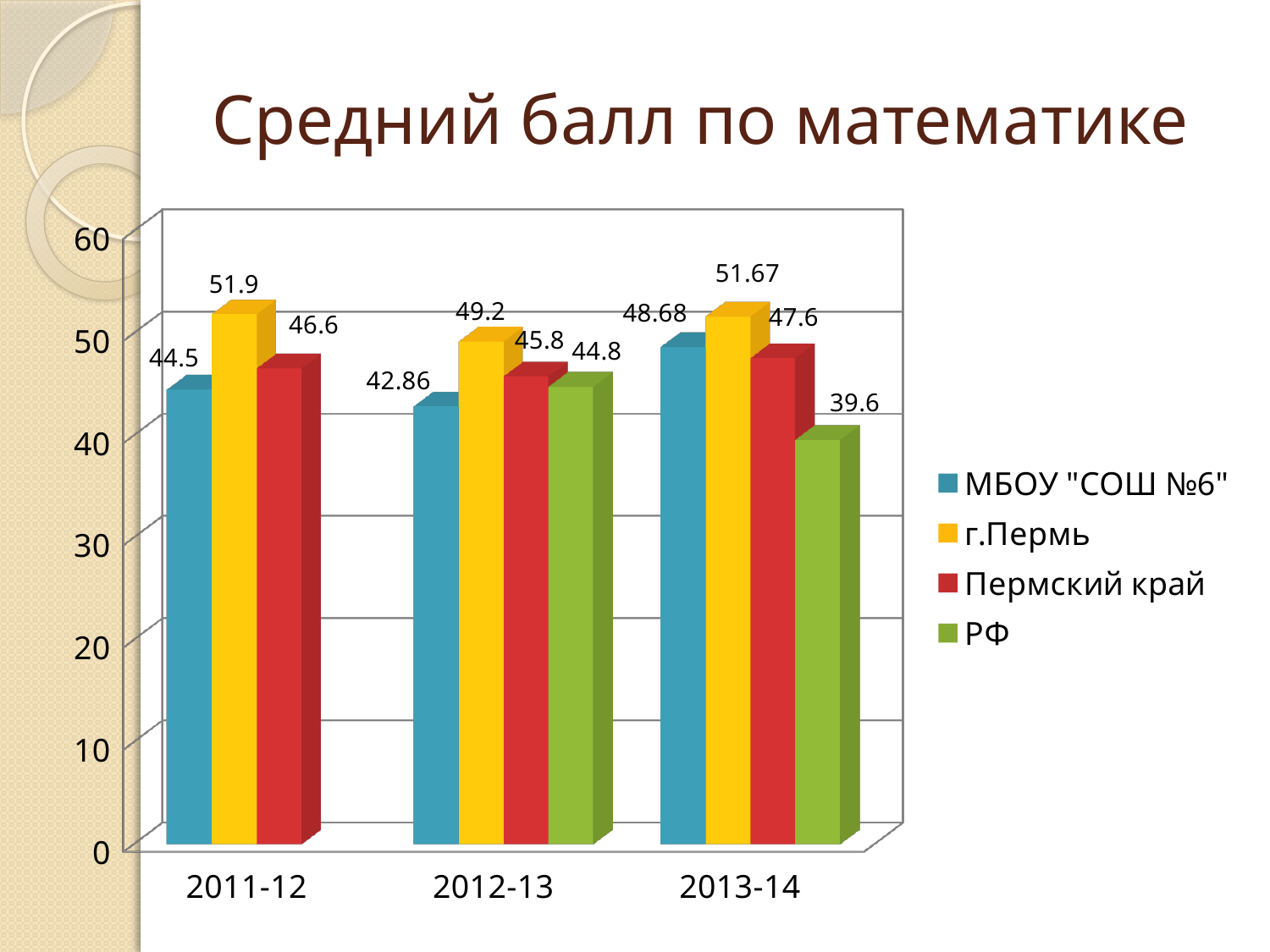
Does the value for МБОУ "СОШ №6" rise or fall from 2012-13 to 2013-14? rise What is the value for МБОУ "СОШ №6" in 2011-12? 44.5 Which series has the lowest value in 2013-14? РФ How many year categories are shown on the x axis? 3 What kind of chart is shown? bar chart How many series does the legend list? 4 Which is larger in 2013-14: МБОУ "СОШ №6" or Пермский край? МБОУ "СОШ №6" What is the value for г.Пермь in 2013-14? 51.67 What is the value for Пермский край in 2013-14? 47.6 What is the difference between г.Пермь and МБОУ "СОШ №6" in 2011-12? 7.4 Which series has the highest value in 2012-13? г.Пермь What is the value for РФ in 2012-13? 44.8